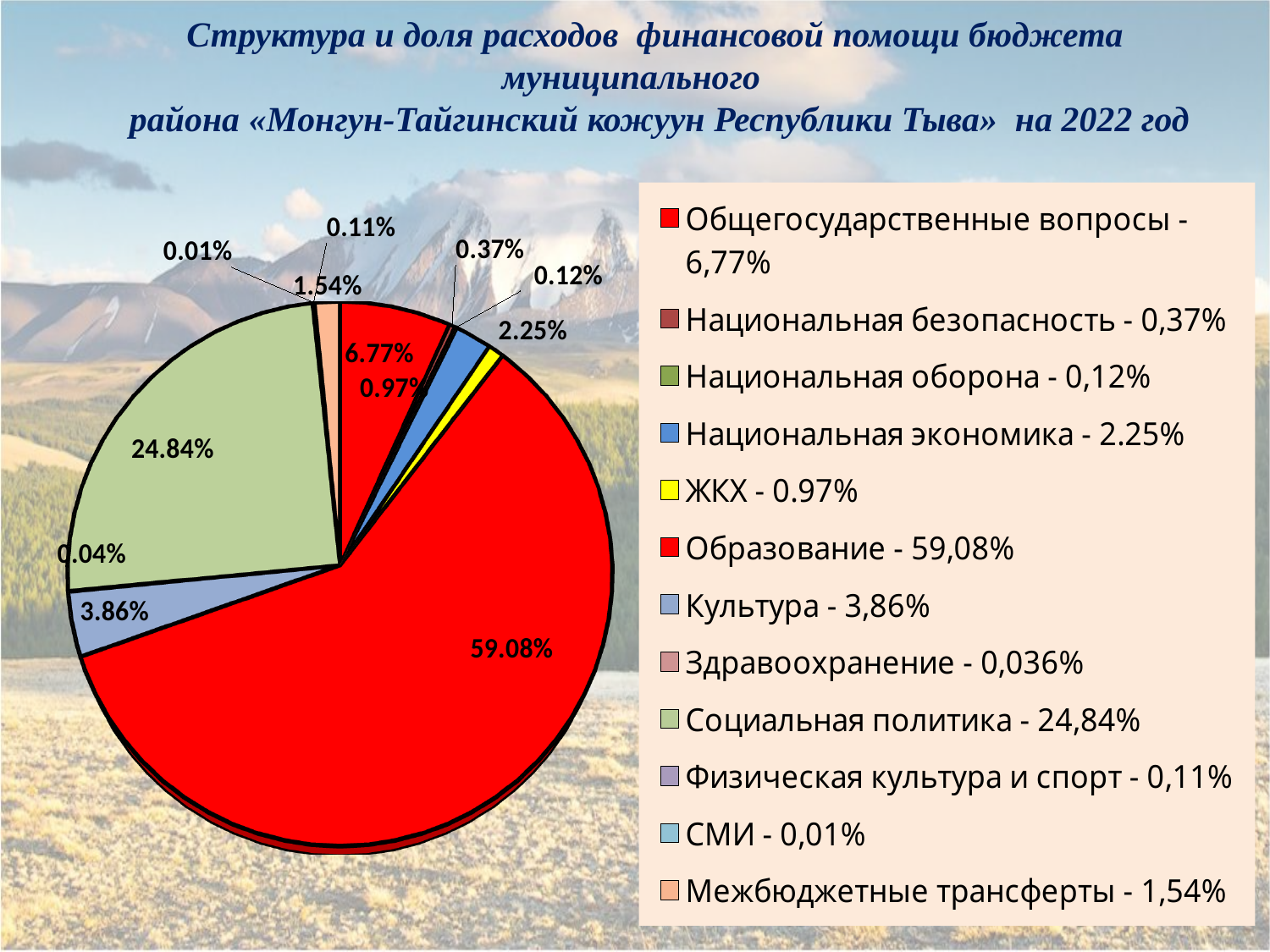
What is the difference between the shares of Образование and Социальная политика in the pie chart? 34.24% What is the share of Социальная политика in the pie chart? 24.84% What kind of chart is shown on the slide? pie chart Which is larger in the pie chart: Социальная политика or Общегосударственные вопросы? Социальная политика How many categories does the legend of the pie chart list? 12 What is the share of Образование in the pie chart? 59.08% Which category has the smallest slice of the pie chart? СМИ What is the share of Национальная экономика in the pie chart? 2.25% Which category has the largest slice of the pie chart? Образование What is the share of Общегосударственные вопросы in the pie chart? 6.77% What is the share of Культура in the pie chart? 3.86% What is the share of Межбюджетные трансферты in the pie chart? 1.54%